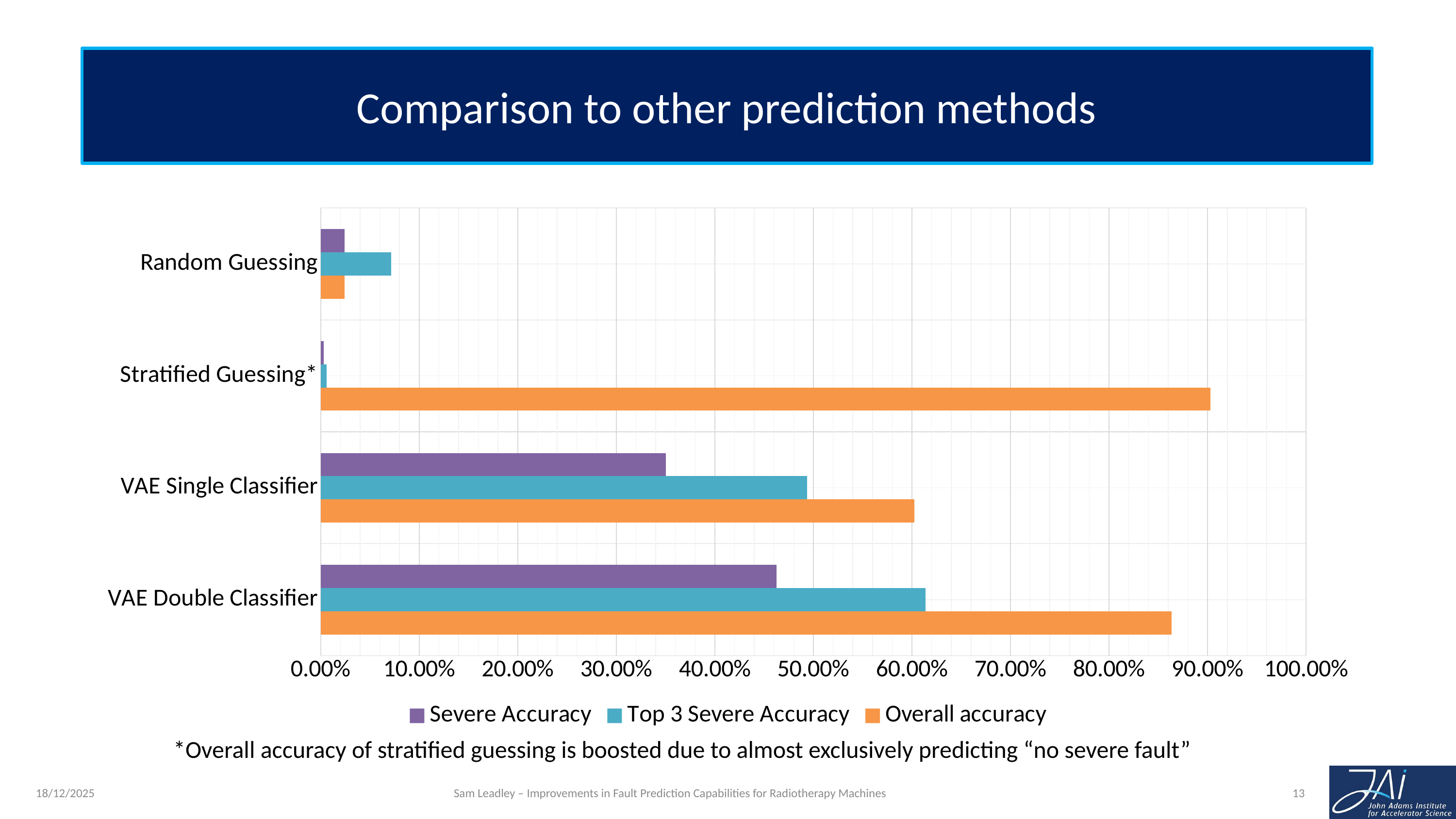
How many prediction methods (categories) are shown on the chart? 4 Which prediction method has the highest Severe Accuracy? VAE Double Classifier How many series does the legend list? 3 Which prediction method has the lowest Top 3 Severe Accuracy? Stratified Guessing* Is the Top 3 Severe Accuracy for Random Guessing greater or less than 10.00%? less Is the Severe Accuracy for VAE Single Classifier greater or less than 40.00%? less Is the Overall accuracy for VAE Single Classifier greater or less than 50.00%? greater Which colour represents the Overall accuracy series in the legend? orange Which has a larger Severe Accuracy, VAE Double Classifier or VAE Single Classifier? VAE Double Classifier What kind of chart is shown on the slide? bar chart Which prediction method has the highest Overall accuracy? Stratified Guessing*